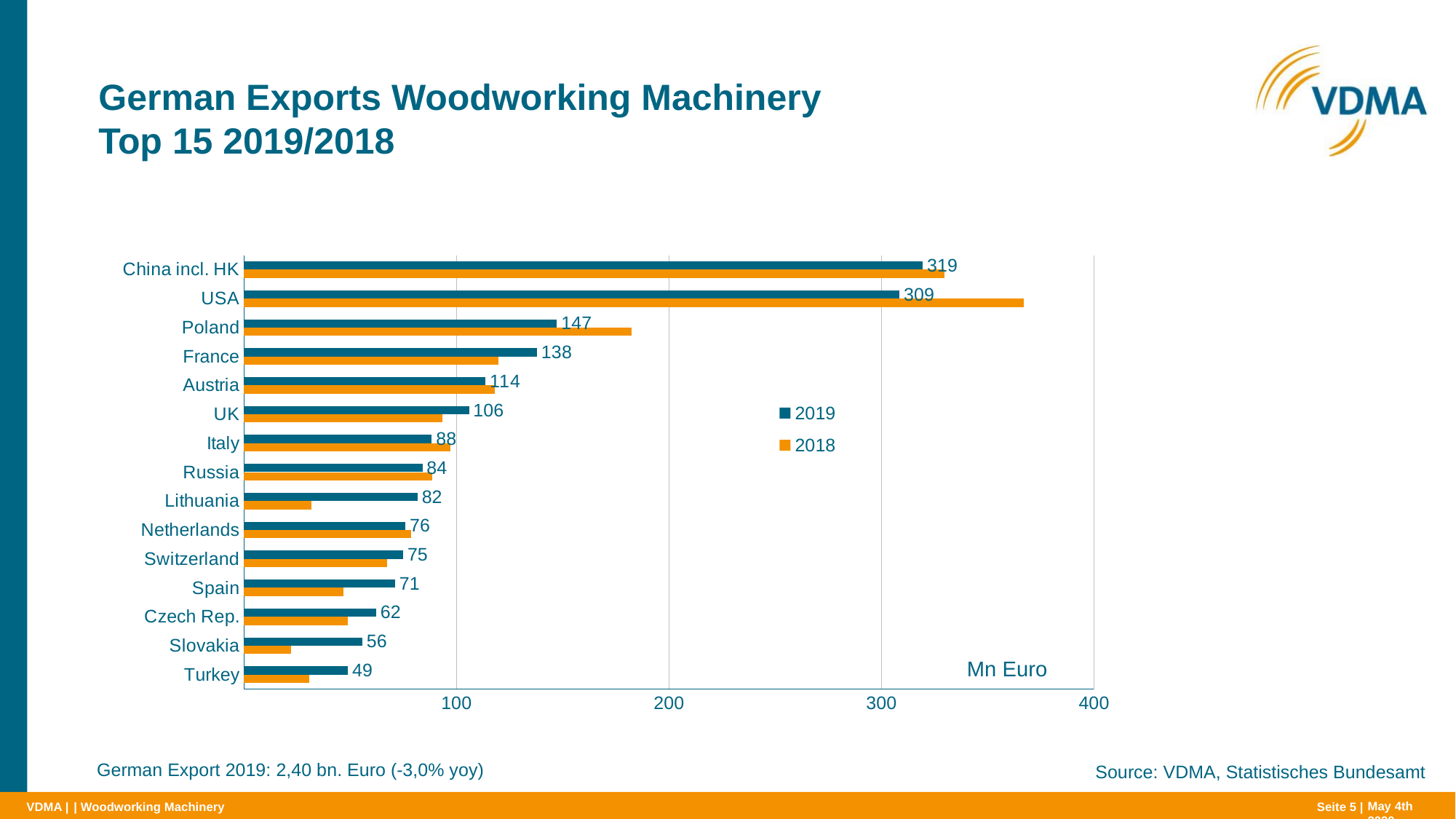
What is the difference between the 2019 values for France and Austria? 24 How many countries are shown in the chart? 15 What was the value for China incl. HK in 2019? 319 What was the value for Lithuania in 2019? 82 Is the 2018 value for the USA greater or less than 300? greater Which had a larger 2019 value, the UK or Italy? UK What was the value for Poland in 2019? 147 What is the difference between the 2019 values for China incl. HK and the USA? 10 How many series does the legend list? 2 Is the 2018 value for Lithuania greater or less than 100? less Which country had the highest value in 2019? China incl. HK Which country had the lowest value in 2019? Turkey